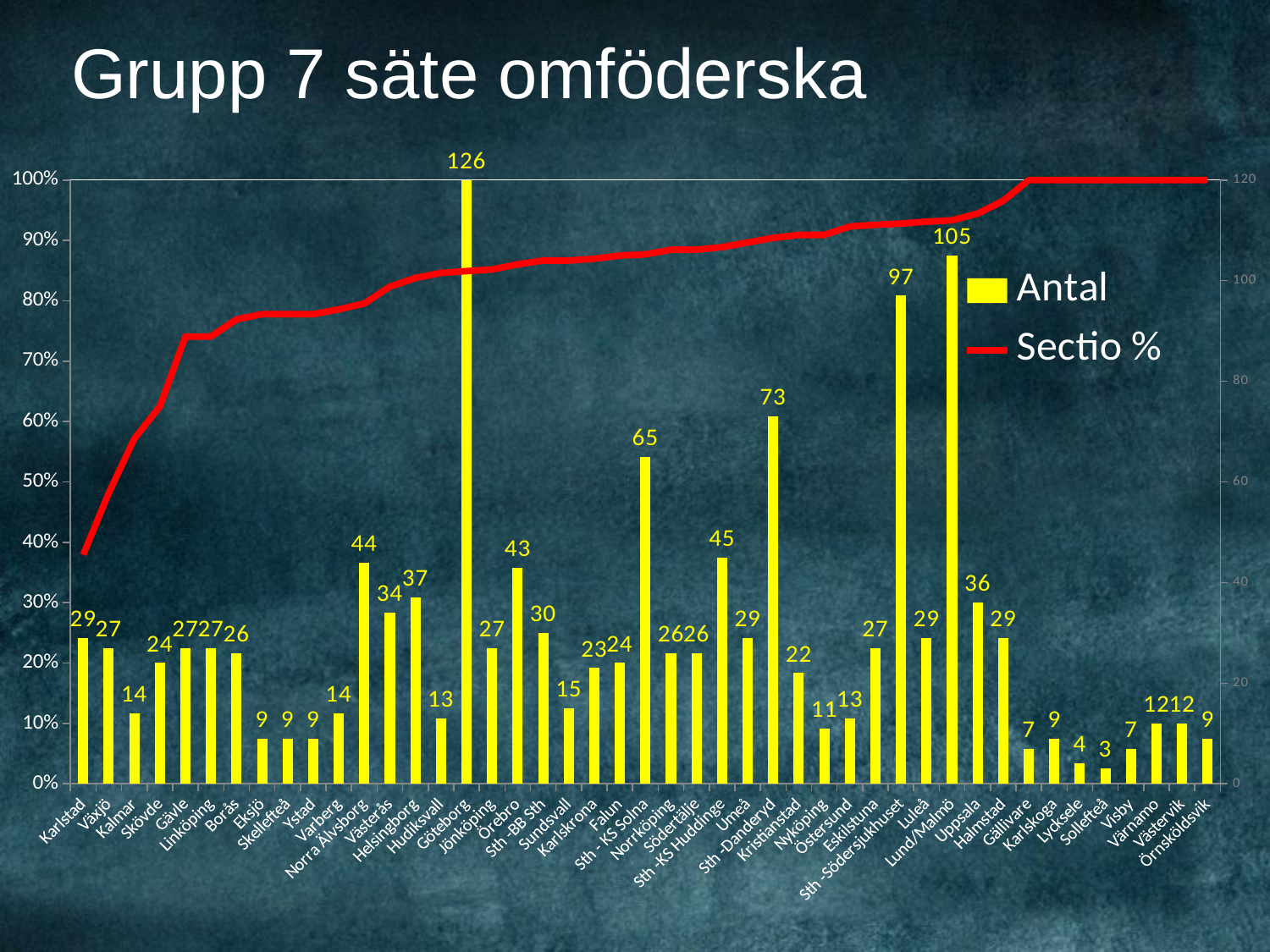
What is the Antal value for Göteborg? 126 How many series does the legend list? 2 Is the Sectio % value for Karlstad greater or less than 50%? less Is the Sectio % value for Gävle greater or less than 70%? greater Which has a larger Antal value, Sth - KS Solna or Sth -KS Huddinge? Sth - KS Solna What is the title of the chart? Grupp 7 säte omföderska Does the Sectio % line rise or fall from left to right along the x axis? rise What is the Antal value for Sth -Danderyd? 73 Which category has the highest Antal value? Göteborg Which category has the lowest Antal value? Sollefteå What is the difference in Antal between Göteborg and Lund/Malmö? 21 What is the Antal value for Lund/Malmö? 105